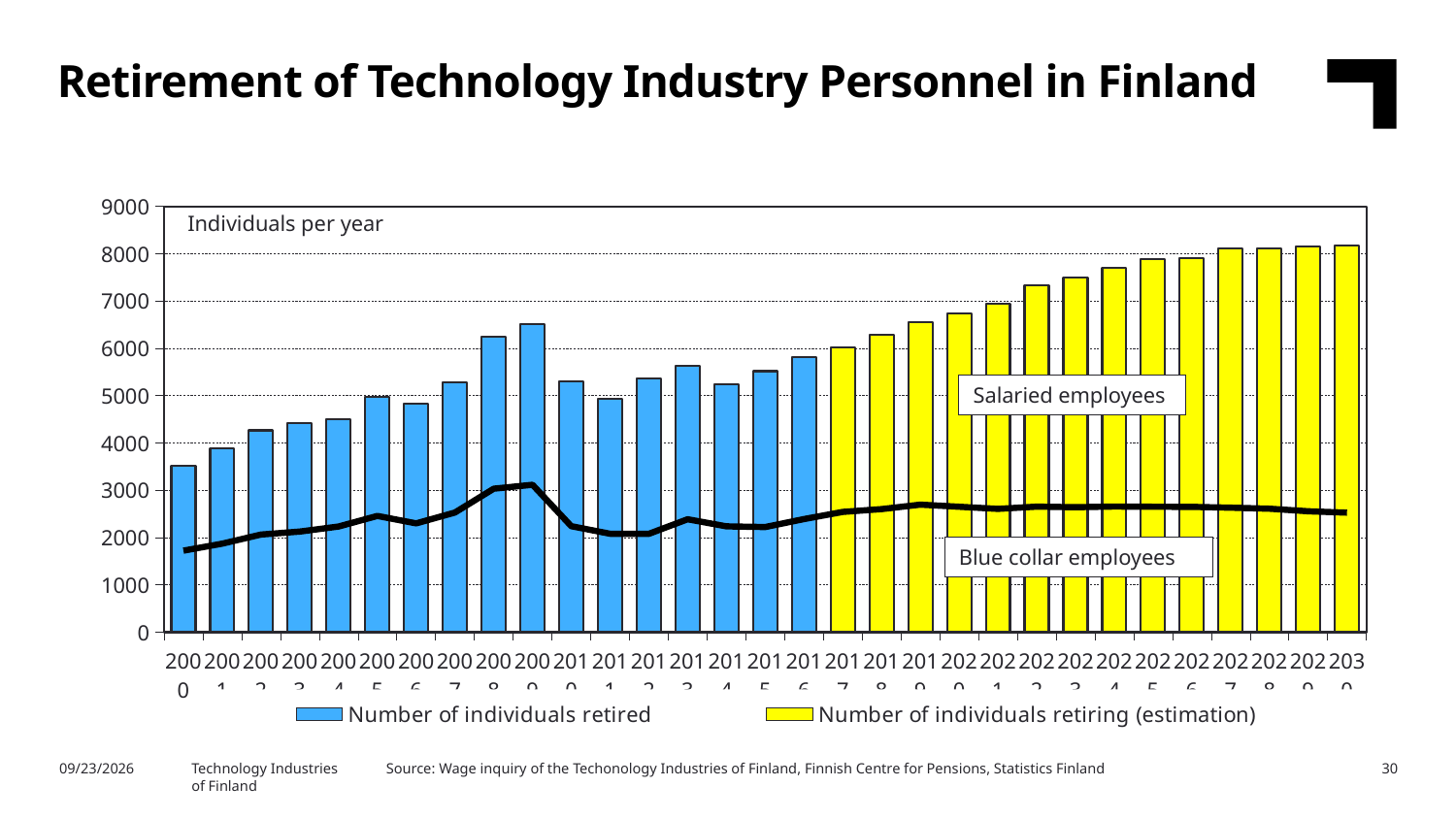
What kind of chart is shown on the slide? Combination bar and line chart Is the value for 2009 greater or less than 6000? greater Is the value for 2000 greater or less than 3000? greater How many series does the legend list? 2 Which year has the larger bar, 2009 or 2010? 2009 How many years (bars) are plotted on the chart? 31 What is the legend label for the yellow bars? Number of individuals retiring (estimation) Is the value for 2030 greater or less than 8000? greater Do the estimated values (yellow bars) rise or fall from 2017 to 2030? rise What label is shown at the top of the vertical axis area of the chart? Individuals per year Which year has the lowest bar on the chart? 2000